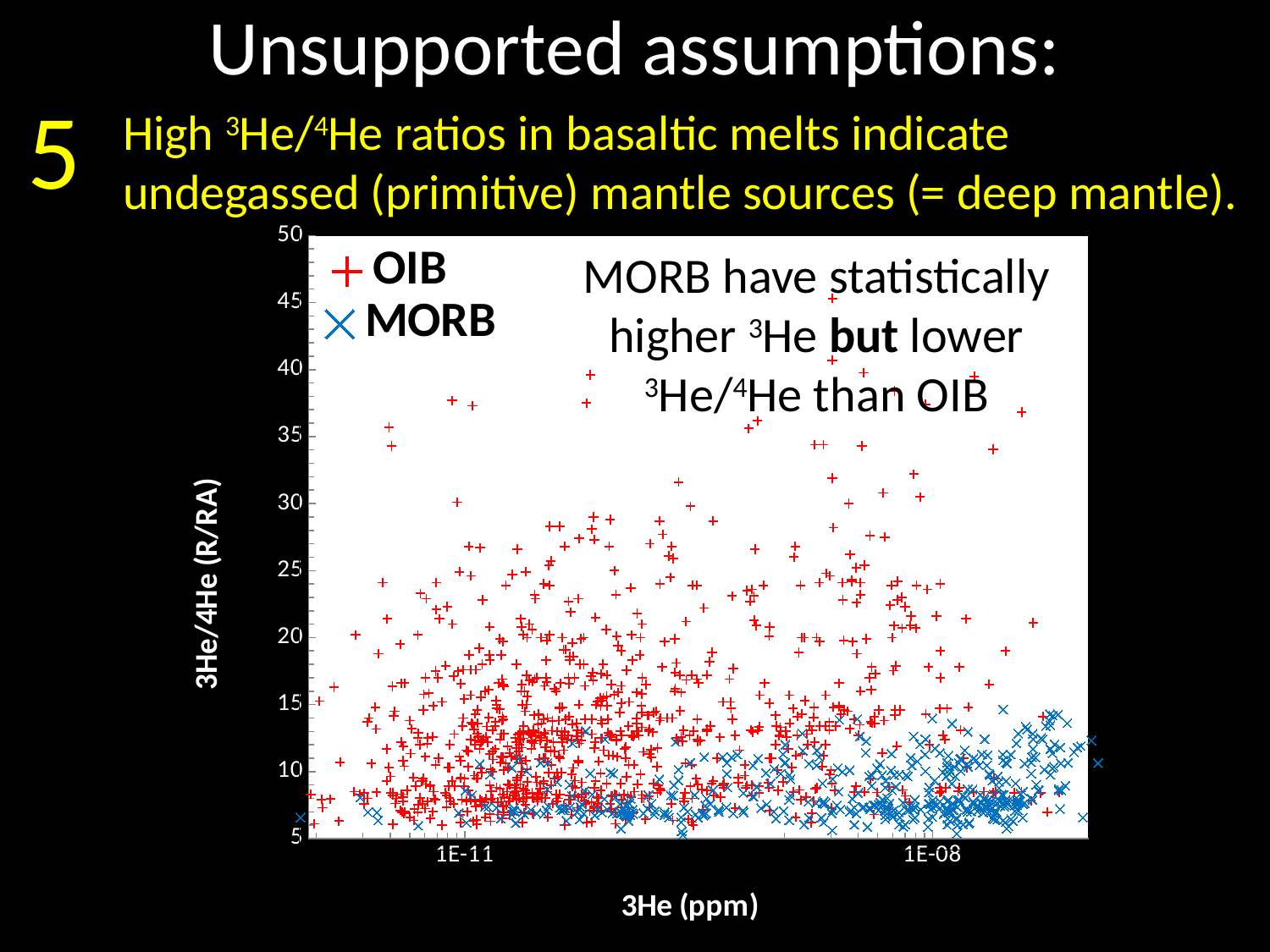
Which series is concentrated at higher 3He (ppm) values, OIB or MORB? MORB How many series does the chart legend list? 2 What is the label of the x axis? 3He (ppm) What is the label of the y axis? 3He/4He (R/RA) What colour and marker are used for the MORB series? blue x What is the highest value shown on the y axis? 50 Is the highest 3He/4He value for the OIB series greater or less than 35? greater Is the highest 3He/4He value for the MORB series greater or less than 20? less What are the two series named in the chart legend? OIB and MORB What kind of chart is shown on the slide? scatter plot Which series reaches higher 3He/4He (R/RA) values, OIB or MORB? OIB What is the lowest value shown on the y axis? 5